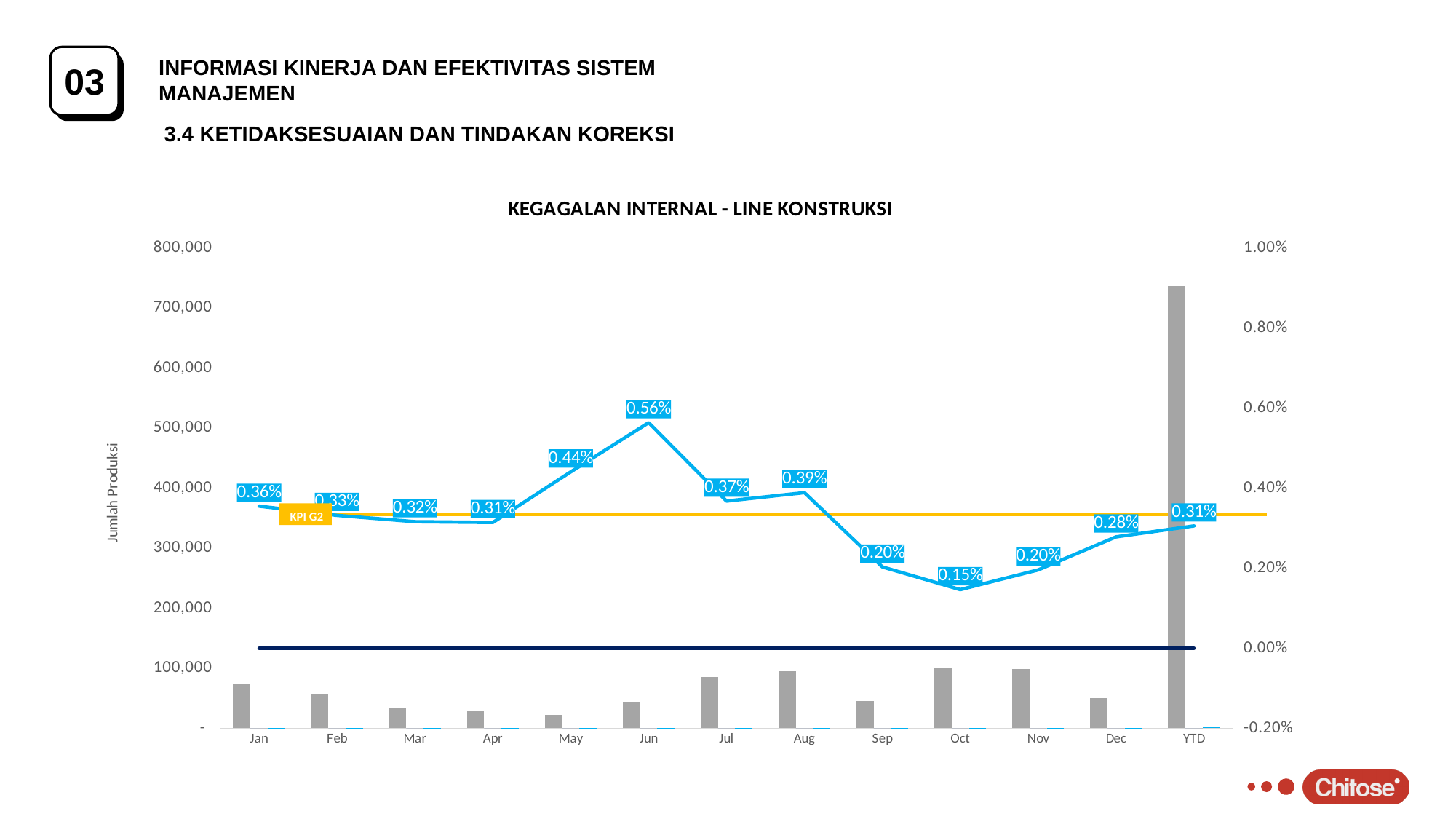
How many categories are shown on the x axis? 13 Which month has the highest percentage value on the line? Jun What is the percentage value shown for Oct on the line? 0.15% Which month has the lowest percentage value on the line? Oct What is the title of the chart? KEGAGALAN INTERNAL - LINE KONSTRUKSI Is the value of the Jan bar greater or less than 100,000? less What is the difference between the percentage values for Jun and Oct? 0.41% What kind of chart is this? Combination bar and line chart Which has a higher percentage value on the line, May or Aug? May What is the percentage value shown for Jun on the line? 0.56% Is the value of the YTD bar greater or less than 700,000? greater What is the percentage value shown for YTD on the line? 0.31%